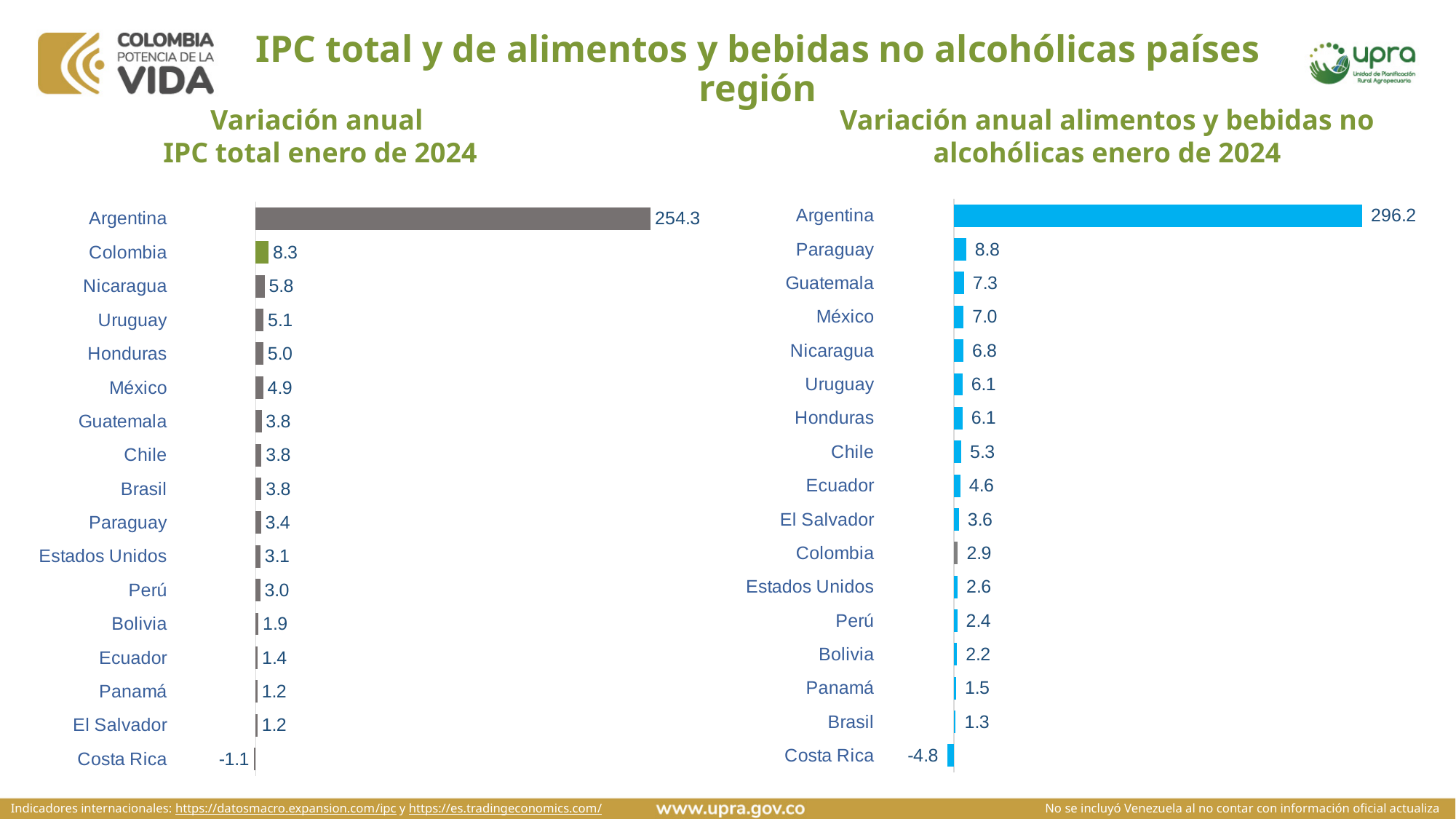
In the 'Variación anual alimentos y bebidas no alcohólicas enero de 2024' chart, which is larger, the value for México or the value for Chile? México In the 'Variación anual alimentos y bebidas no alcohólicas enero de 2024' chart, what is the value for Colombia? 2.9 In the 'Variación anual IPC total enero de 2024' chart, which country has the highest value? Argentina In the 'Variación anual alimentos y bebidas no alcohólicas enero de 2024' chart, which country has the lowest value? Costa Rica In the 'Variación anual IPC total enero de 2024' chart, what is the difference between the values for Argentina and Colombia? 246.0 In the 'Variación anual alimentos y bebidas no alcohólicas enero de 2024' chart, what is the difference between the values for Argentina and Costa Rica? 301.0 How many countries are shown in the 'Variación anual IPC total enero de 2024' chart? 17 In the 'Variación anual IPC total enero de 2024' chart, what is the value for Costa Rica? -1.1 In the 'Variación anual IPC total enero de 2024' chart, which bar is coloured green rather than grey? Colombia What type of chart is the 'Variación anual alimentos y bebidas no alcohólicas enero de 2024' chart? Bar chart In the 'Variación anual alimentos y bebidas no alcohólicas enero de 2024' chart, what is the value for Paraguay? 8.8 In the 'Variación anual IPC total enero de 2024' chart, what is the value for Colombia? 8.3